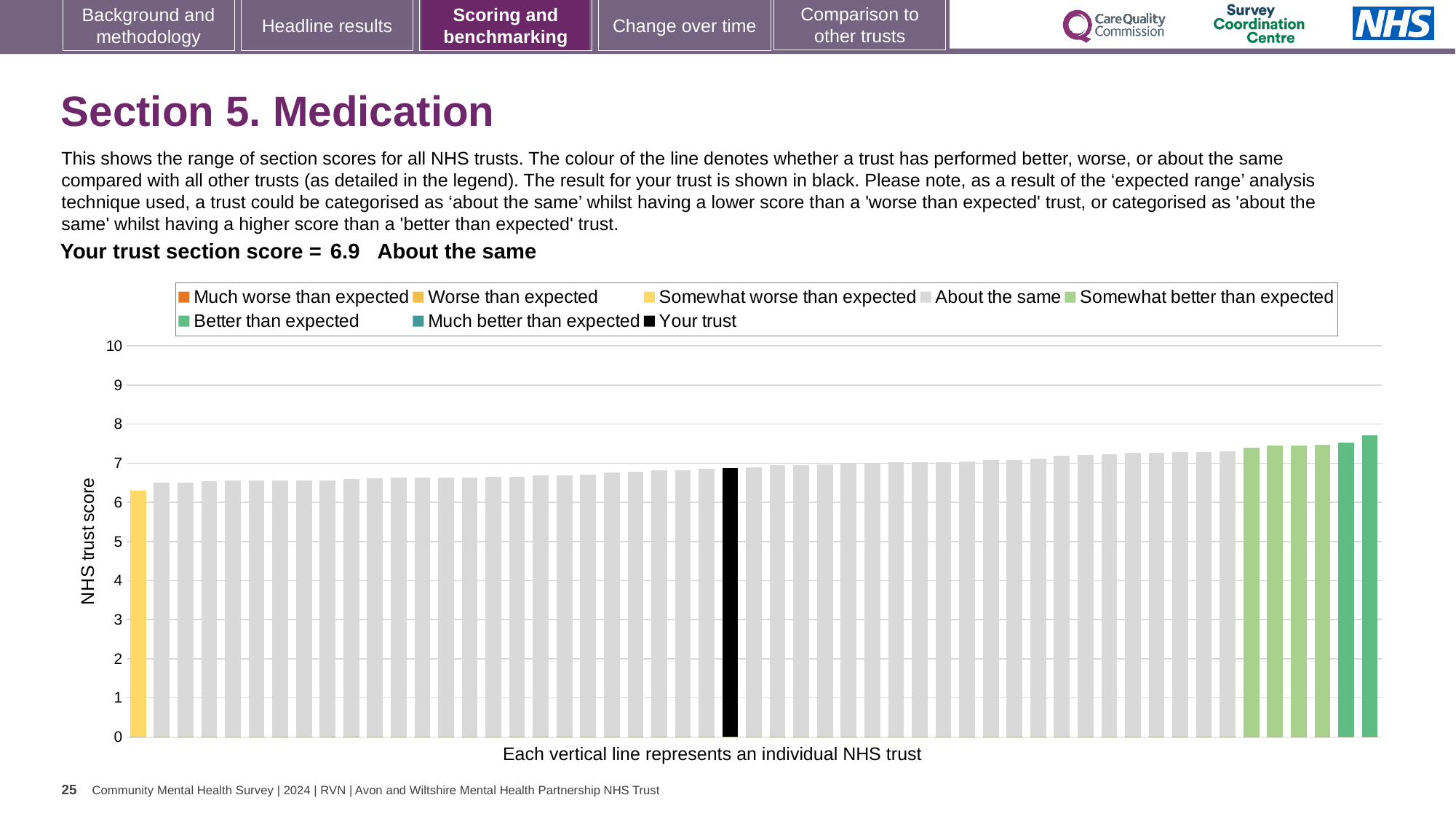
Is the value of the tallest bar greater or less than 8? less How is your trust's section score categorised compared with other trusts? About the same Is the value of the tallest bar greater or less than 7? greater Is the value of the shortest bar (the yellow bar) greater or less than 7? less What is the label on the vertical axis of the chart? NHS trust score What is the section score for your trust shown on the slide? 6.9 Do the bar values rise or fall moving from left to right along the x axis? rise Which is larger: the black bar for your trust or the yellow bar at the far left? the black bar for your trust How many entries does the chart legend list? 8 What colour is the bar representing your trust? black What kind of chart is shown on the slide? bar chart